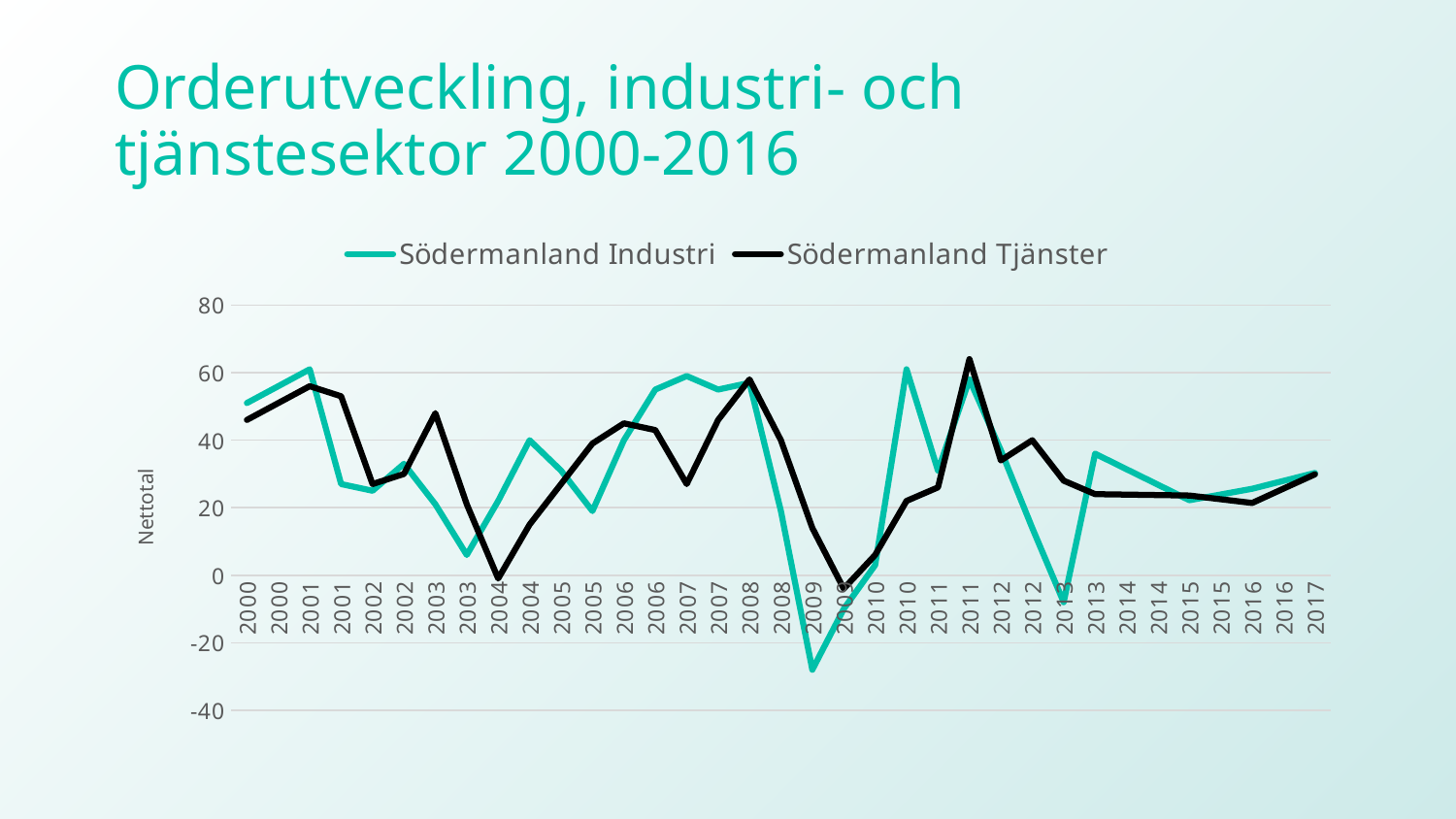
At which x-axis label does Södermanland Industri reach its lowest value? 2009 At the second 2003 point, which series has the larger value, Södermanland Industri or Södermanland Tjänster? Södermanland Tjänster Is the value of Södermanland Tjänster at the second 2011 point greater or less than 40? greater How many points are labelled along the x axis? 35 What is the label on the vertical axis? Nettotal What are the two series named in the legend? Södermanland Industri and Södermanland Tjänster At which x-axis label does Södermanland Tjänster reach its highest value? 2011 What kind of chart is shown on the slide? line chart Does Södermanland Industri rise or fall between the second 2008 point and the second 2009 point? fall Is the value of Södermanland Industri at the first 2010 point greater or less than 40? less How many series does the legend list? 2